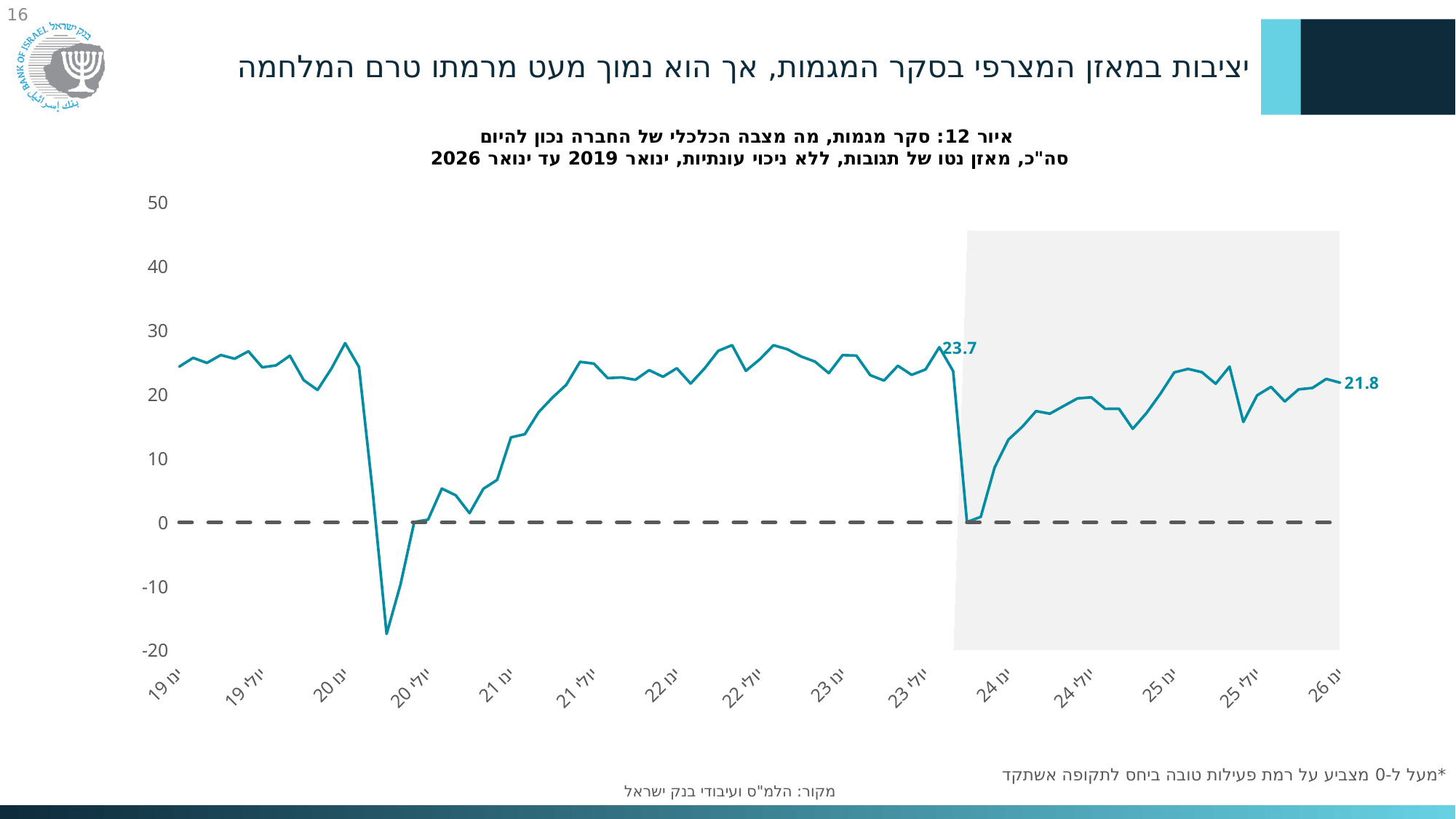
Which labelled value is larger: the one before the shaded area (23.7) or the one at ינו 26 (21.8)? 23.7 Does the line rise or fall between the labelled point 23.7 and the labelled point 21.8 at ינו 26? fall In which year does the line reach its lowest point? 2020 What is the value shown by the data label just before the shaded area begins (around יולי 23)? 23.7 What kind of chart is shown on the slide? line chart Is the value at ינו 19 greater or less than 20? greater Is the lowest point of the line, reached in 2020, greater or less than -10? less Is the value at ינו 21 greater or less than 10? greater What is the difference between the two labelled values, 23.7 and 21.8? 1.9 At what value is the horizontal dashed reference line drawn? 0 What is the value shown by the data label at the end of the line, at ינו 26? 21.8 How many tick labels are shown on the x axis? 15